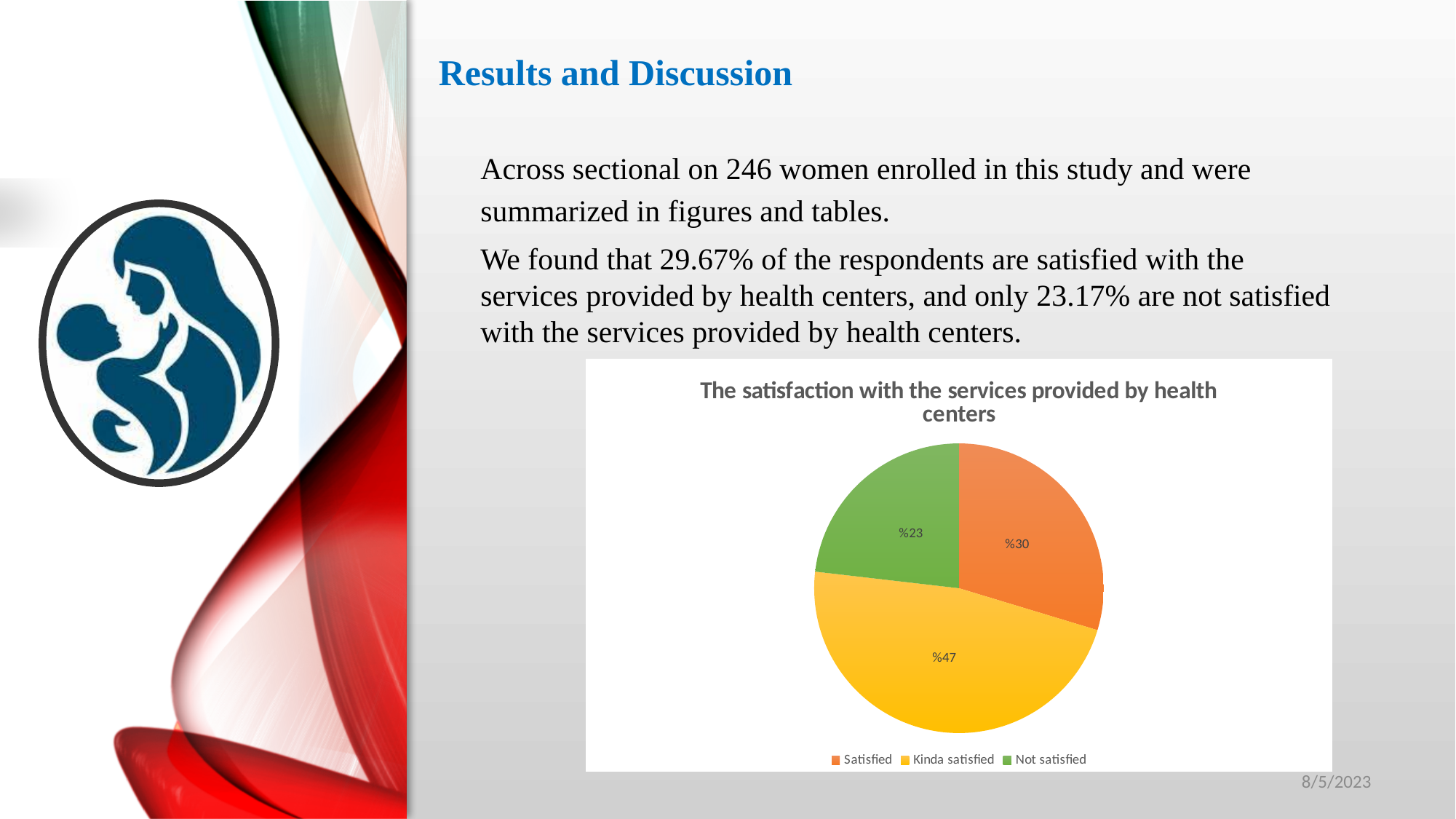
What share of the pie is labelled for the Not satisfied slice? %23 What share of the pie is labelled for the Satisfied slice? %30 Which category has the smallest slice of the pie? Not satisfied How many categories does the legend list? 3 Which category has the largest slice of the pie? Kinda satisfied Which slice is larger, Satisfied or Not satisfied? Satisfied What share of the pie is labelled for the Kinda satisfied slice? %47 What is the difference in percentage points between the Satisfied and Not satisfied slices? 7 What colour is the Kinda satisfied slice? yellow What type of chart is shown on the slide? pie chart What is the title of the chart? The satisfaction with the services provided by health centers What is the difference in percentage points between the Kinda satisfied and Satisfied slices? 17